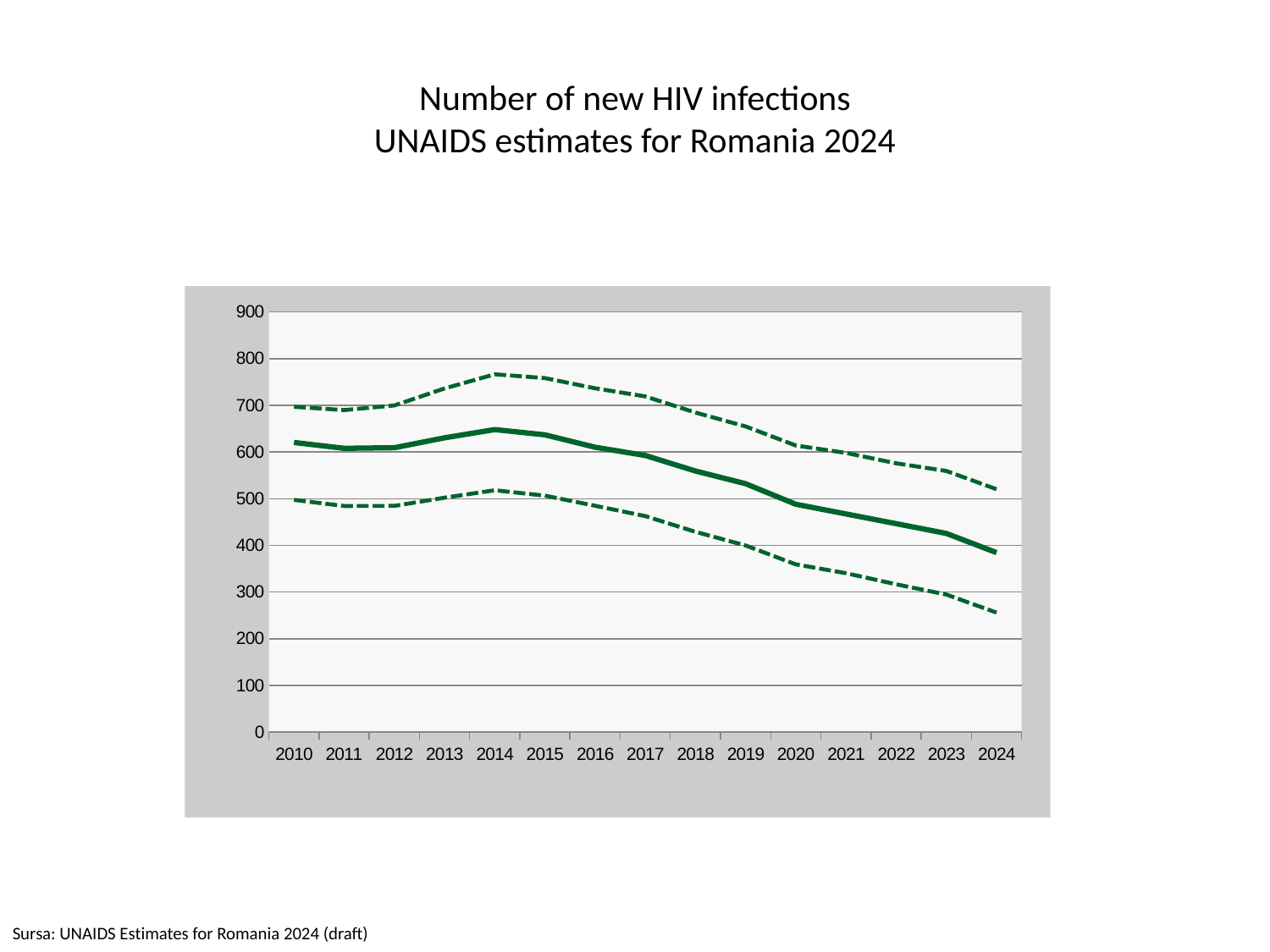
How many years are shown on the x axis? 15 Which year has the larger value on the solid line, 2010 or 2024? 2010 Is the value of the solid line in 2023 greater or less than 500? less Does the solid line rise or fall from 2014 to 2024? fall How many lines are plotted on the chart? 3 In which year does the solid line reach its lowest value? 2024 Is the value of the upper dashed line in 2014 greater or less than 700? greater What kind of chart is shown on the slide? line chart What is the title of the chart? Number of new HIV infections UNAIDS estimates for Romania 2024 Is the value of the lower dashed line in 2024 greater or less than 300? less In which year does the solid line reach its highest value? 2014